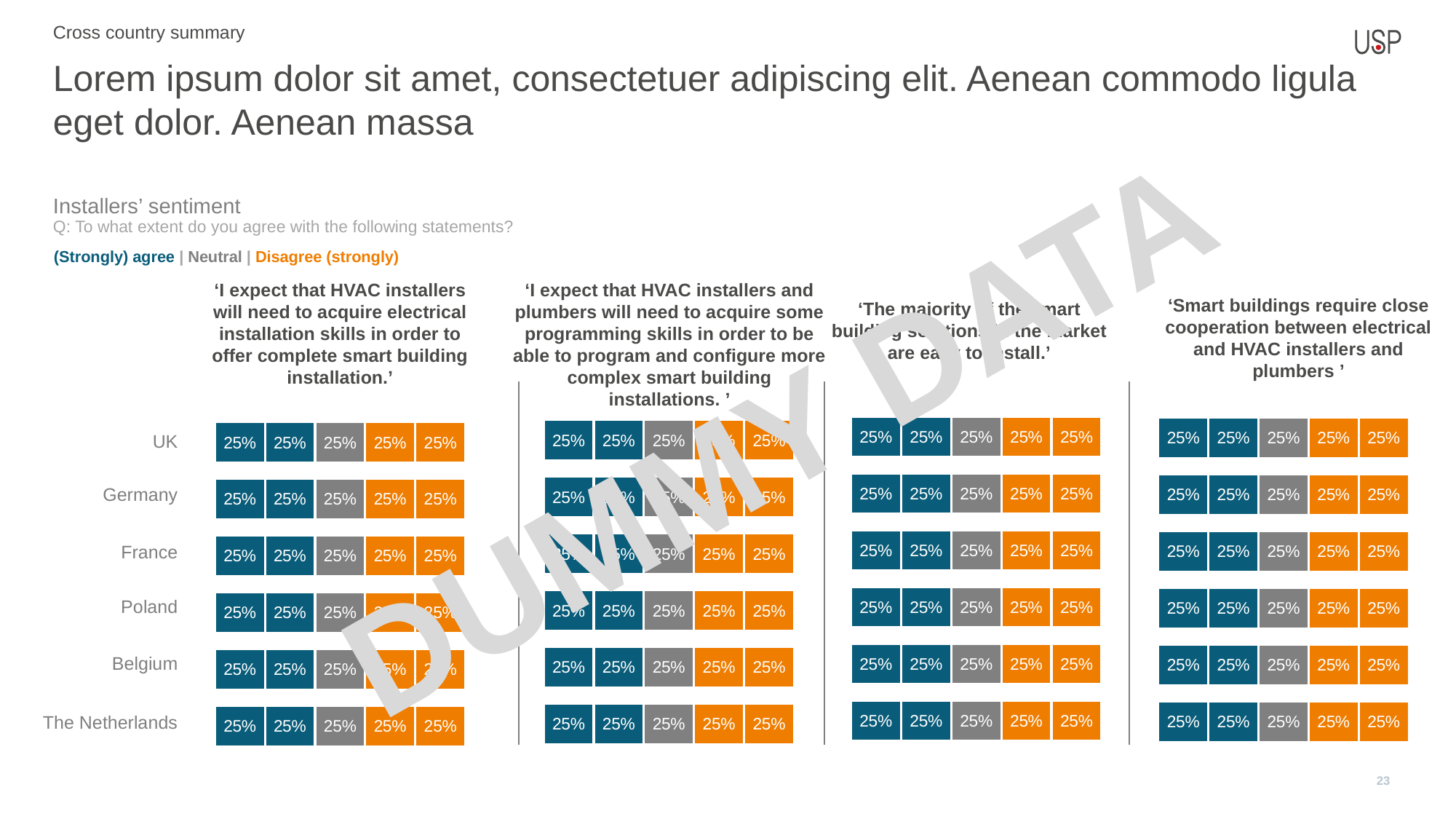
In the chart for the statement 'Smart buildings require close cooperation between electrical and HVAC installers and plumbers', what is the value of the first segment of the UK bar? 25% Which legend entry is shown in orange in the installers' sentiment charts? Disagree (strongly) What kind of chart is used to show the installers' sentiment for each statement? Stacked bar chart How many separate statement charts are shown on the slide? 4 In the leftmost chart ('I expect that HVAC installers will need to acquire electrical installation skills...'), what is the value of the last segment of the France bar? 25% How many entries does the legend list for the installers' sentiment charts? 3 Which country is listed first (at the top) in the installers' sentiment charts? UK In the chart for the statement 'The majority of the smart building solutions on the market are easy to install', what is the value of the grey (Neutral) segment for Germany? 25% How many countries are listed as categories in the chart for the statement 'Smart buildings require close cooperation between electrical and HVAC installers and plumbers'? 6 In the chart for the statement 'Smart buildings require close cooperation between electrical and HVAC installers and plumbers', what is the value of the middle segment for The Netherlands? 25% How many segments make up each country's bar in the chart for the statement 'The majority of the smart building solutions on the market are easy to install'? 5 In the chart for the statement 'Smart buildings require close cooperation between electrical and HVAC installers and plumbers', what is the value of the second segment of the Poland bar? 25%